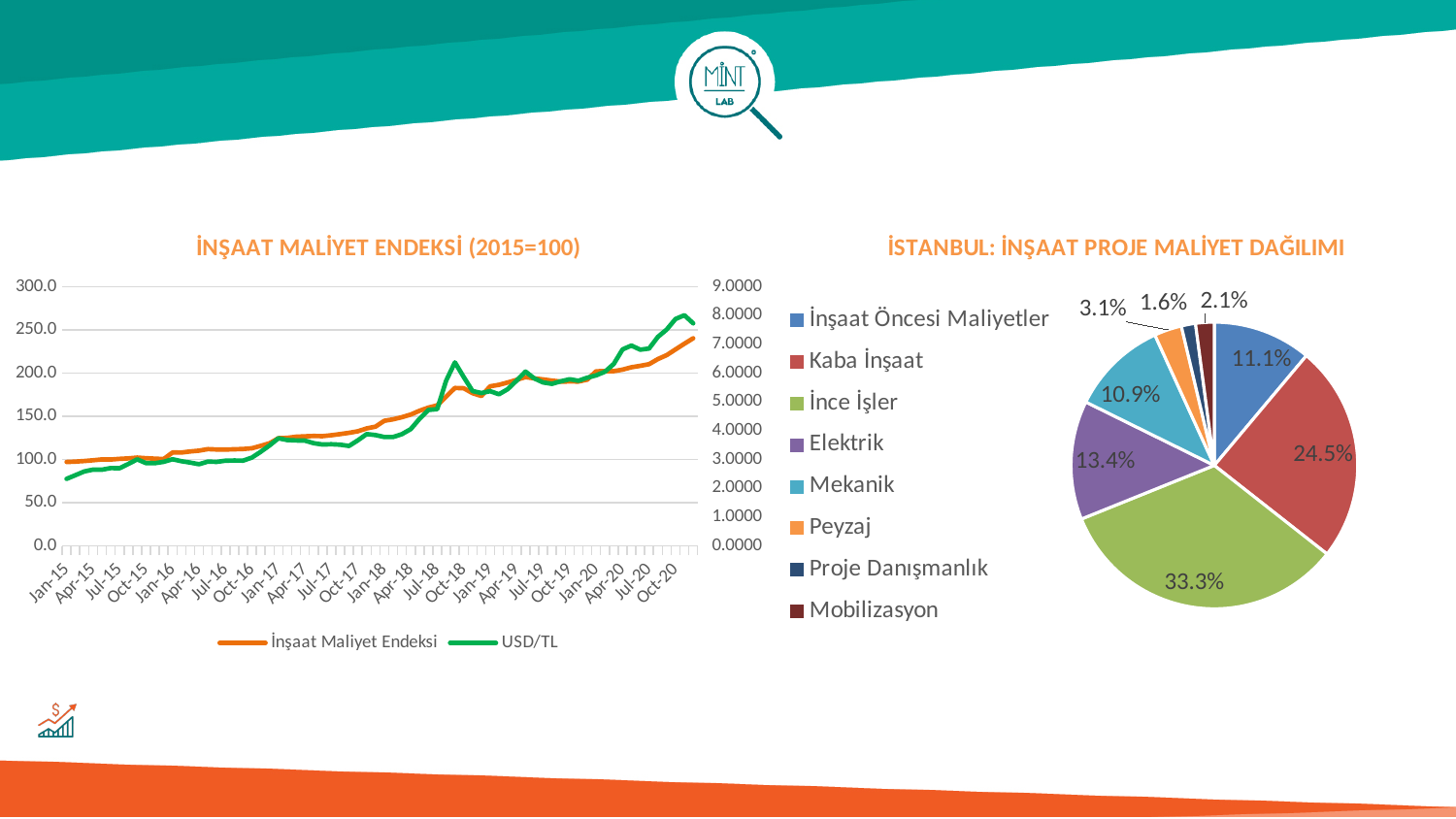
How many categories does the İSTANBUL: İNŞAAT PROJE MALİYET DAĞILIMI pie chart show? 8 In the İSTANBUL: İNŞAAT PROJE MALİYET DAĞILIMI pie chart, which category has the largest share? İnce İşler In the İNŞAAT MALİYET ENDEKSİ (2015=100) chart, is the İnşaat Maliyet Endeksi value at Oct-20 greater or less than 200.0? greater In the İSTANBUL: İNŞAAT PROJE MALİYET DAĞILIMI pie chart, which category has the smallest share? Proje Danışmanlık In the İSTANBUL: İNŞAAT PROJE MALİYET DAĞILIMI pie chart, what is the difference between the shares of Kaba İnşaat and İnşaat Öncesi Maliyetler? 13.4% What type of chart is the İNŞAAT MALİYET ENDEKSİ (2015=100) chart? Line chart In the İNŞAAT MALİYET ENDEKSİ (2015=100) chart, does the İnşaat Maliyet Endeksi series generally rise or fall from Jan-15 to Oct-20? Rise How many series does the legend of the İNŞAAT MALİYET ENDEKSİ (2015=100) chart list? 2 In the İSTANBUL: İNŞAAT PROJE MALİYET DAĞILIMI pie chart, what share does Elektrik have? 13.4% In the İSTANBUL: İNŞAAT PROJE MALİYET DAĞILIMI pie chart, which has a larger share, Mekanik or Elektrik? Elektrik In the İSTANBUL: İNŞAAT PROJE MALİYET DAĞILIMI pie chart, what share does İnce İşler have? 33.3% In the İSTANBUL: İNŞAAT PROJE MALİYET DAĞILIMI pie chart, what share does Kaba İnşaat have? 24.5%